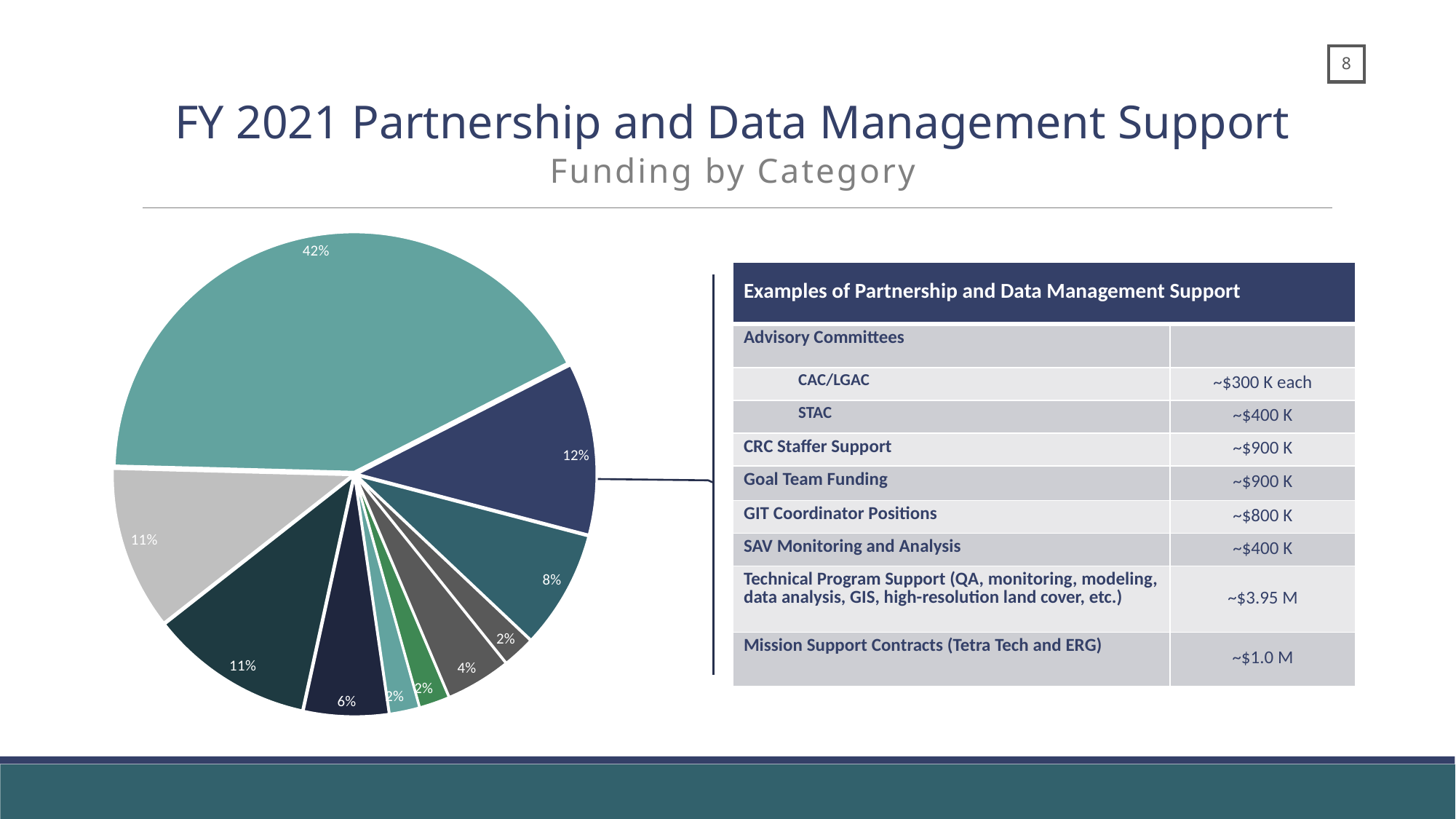
By how many percentage points does the largest slice (42%) exceed the second-largest slice (12%)? 30 percentage points How many slices does the pie chart have? 10 What is the share of the smallest slices in the pie chart? 2% Does the pie chart include a legend naming its categories? No How many slices in the pie chart are labeled 11%? 2 What is the share of the second-largest slice in the pie chart? 12% What kind of chart is shown on the left of the slide? pie chart How many slices in the pie chart are labeled 2%? 3 Which is larger in the pie chart: the slice labeled 8% or the slice labeled 6%? the 8% slice What is the share of the largest slice in the pie chart? 42% What is the subtitle of the chart slide? Funding by Category